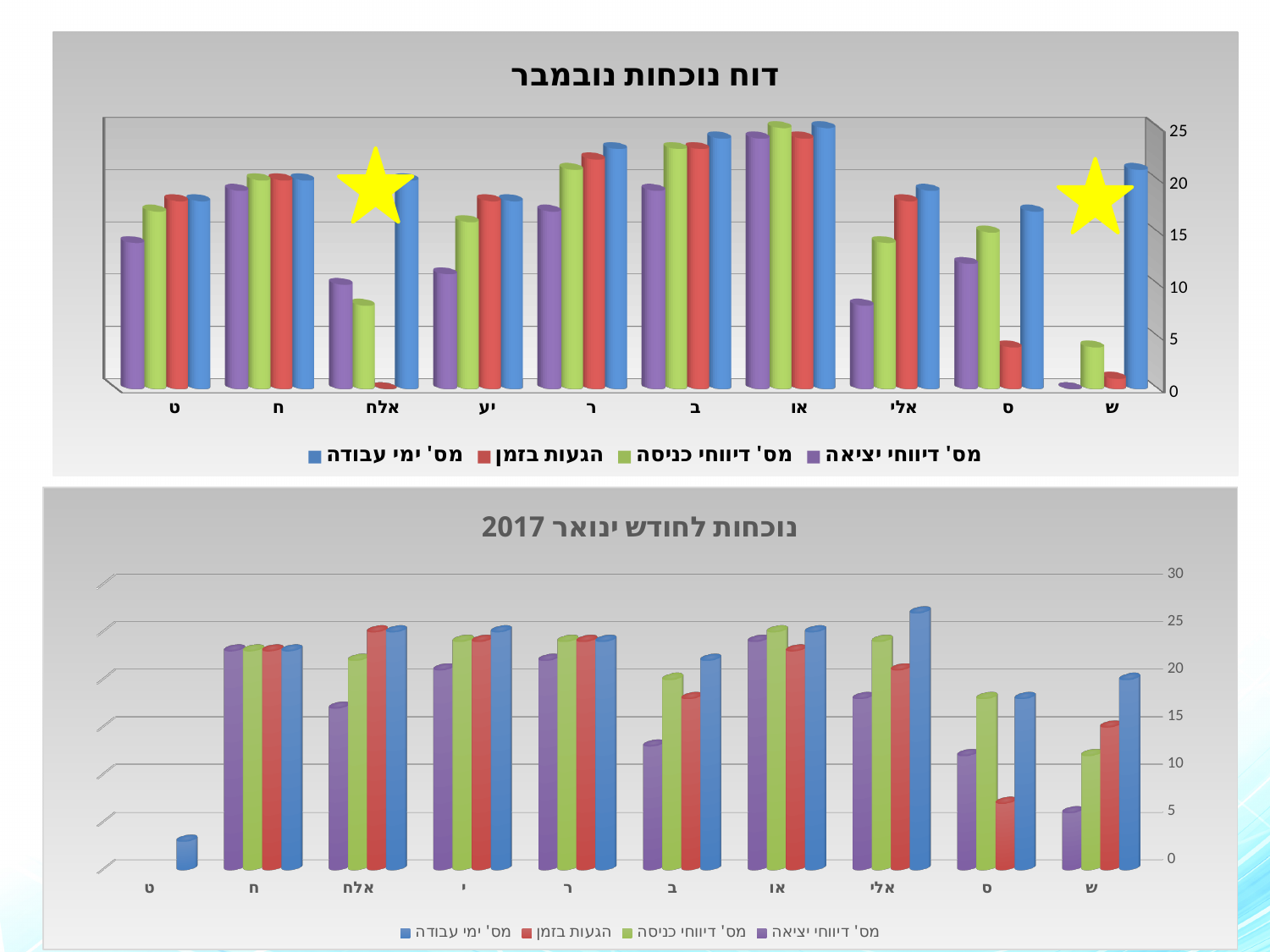
In the top chart 'דוח נוכחות נובמבר', for category ב, which is larger: 'מס' דיווחי כניסה' or 'מס' דיווחי יציאה'? מס' דיווחי כניסה In the top chart 'דוח נוכחות נובמבר', is the value of 'הגעות בזמן' for ס greater or less than 5? less What kind of chart is the top chart titled 'דוח נוכחות נובמבר'? bar chart In the top chart 'דוח נוכחות נובמבר', which category has the highest value for 'מס' ימי עבודה'? או How many categories are shown on the x axis of the top chart 'דוח נוכחות נובמבר'? 10 In the top chart 'דוח נוכחות נובמבר', is the value of 'מס' ימי עבודה' for ש greater or less than 20? greater How many series does the legend of the bottom chart 'נוכחות לחודש ינואר 2017' list? 4 In the bottom chart 'נוכחות לחודש ינואר 2017', for category ש, which is larger: 'מס' ימי עבודה' or 'מס' דיווחי יציאה'? מס' ימי עבודה In the bottom chart 'נוכחות לחודש ינואר 2017', is the value of 'מס' ימי עבודה' for ט greater or less than 5? less In the bottom chart 'נוכחות לחודש ינואר 2017', which category has the highest value for 'מס' ימי עבודה'? אלי What is the title of the top chart on the slide? דוח נוכחות נובמבר In the top chart 'דוח נוכחות נובמבר', which category has the lowest value for 'מס' דיווחי כניסה'? ש